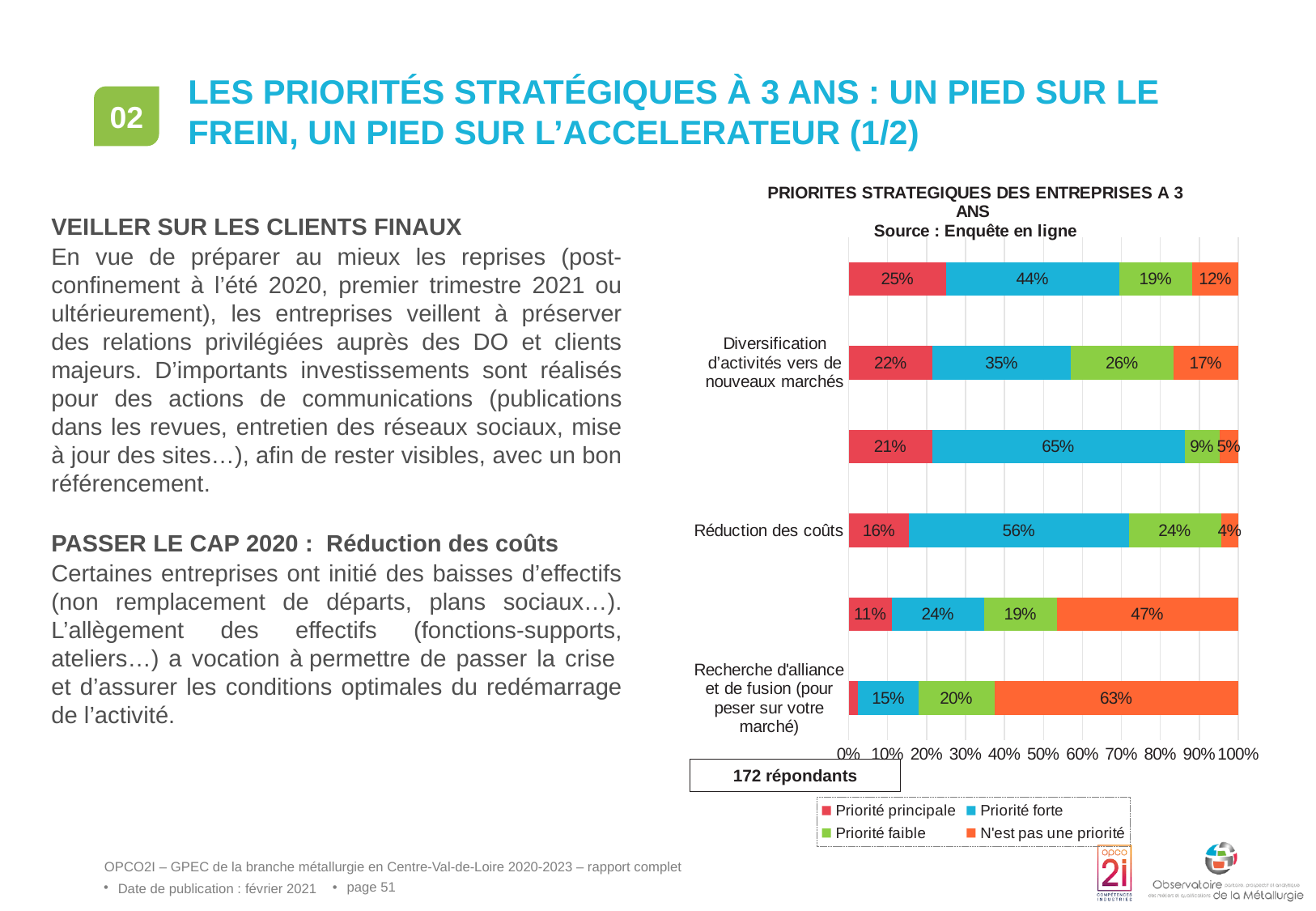
What is the 'Priorité faible' value for 'Diversification d'activités vers de nouveaux marchés'? 26% What is the 'N'est pas une priorité' value for 'Réduction des coûts'? 4% How many series does the legend list? 4 What percentage of respondents rated 'Réduction des coûts' as a 'Priorité forte'? 56% For 'Recherche d'alliance et de fusion', which priority level has the largest share? N'est pas une priorité What is the 'Priorité principale' value for 'Diversification d'activités vers de nouveaux marchés'? 22% What share of respondents said 'Recherche d'alliance et de fusion' is 'N'est pas une priorité'? 63% How many respondents does the chart note indicate? 172 répondants Which has the larger 'Priorité forte' share: 'Réduction des coûts' or 'Diversification d'activités vers de nouveaux marchés'? Réduction des coûts What kind of chart is shown on the slide? Stacked bar chart How many bars are plotted in the chart? 6 What is the difference in 'Priorité forte' share between 'Réduction des coûts' and 'Diversification d'activités vers de nouveaux marchés'? 21 percentage points